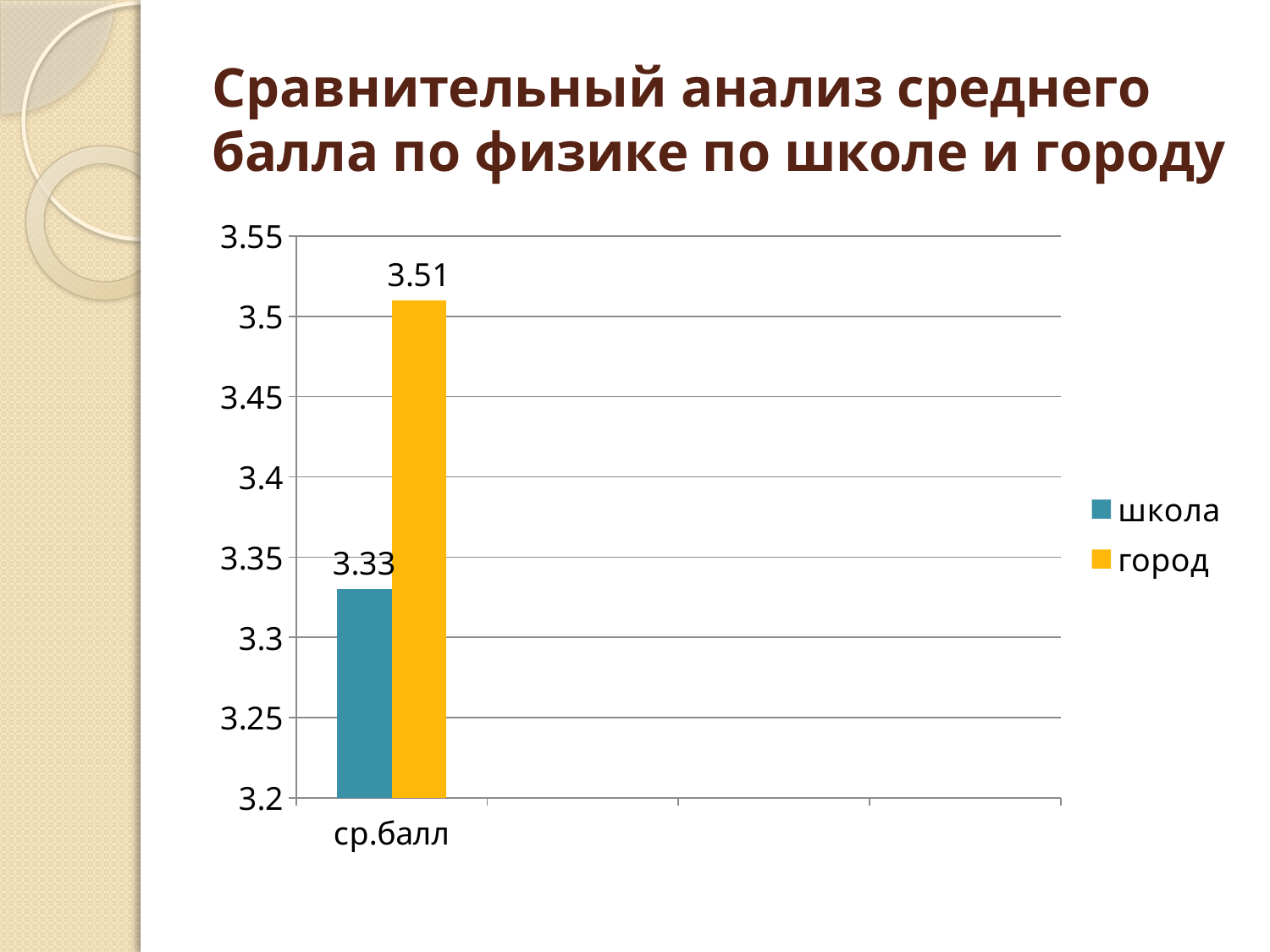
Is the value for город greater or less than 3.5? greater What is the value for школа in the ср.балл category? 3.33 Which series has the lowest value? школа What is the difference between the город value and the школа value? 0.18 What is the value for город in the ср.балл category? 3.51 How many categories are shown on the x axis? 1 How many series does the legend list? 2 Which series has the higher value: школа or город? город What is the title of the slide? Сравнительный анализ среднего балла по физике по школе и городу Is the value for школа greater or less than 3.35? less What colour is the bar for город? yellow What kind of chart is shown on the slide? bar chart